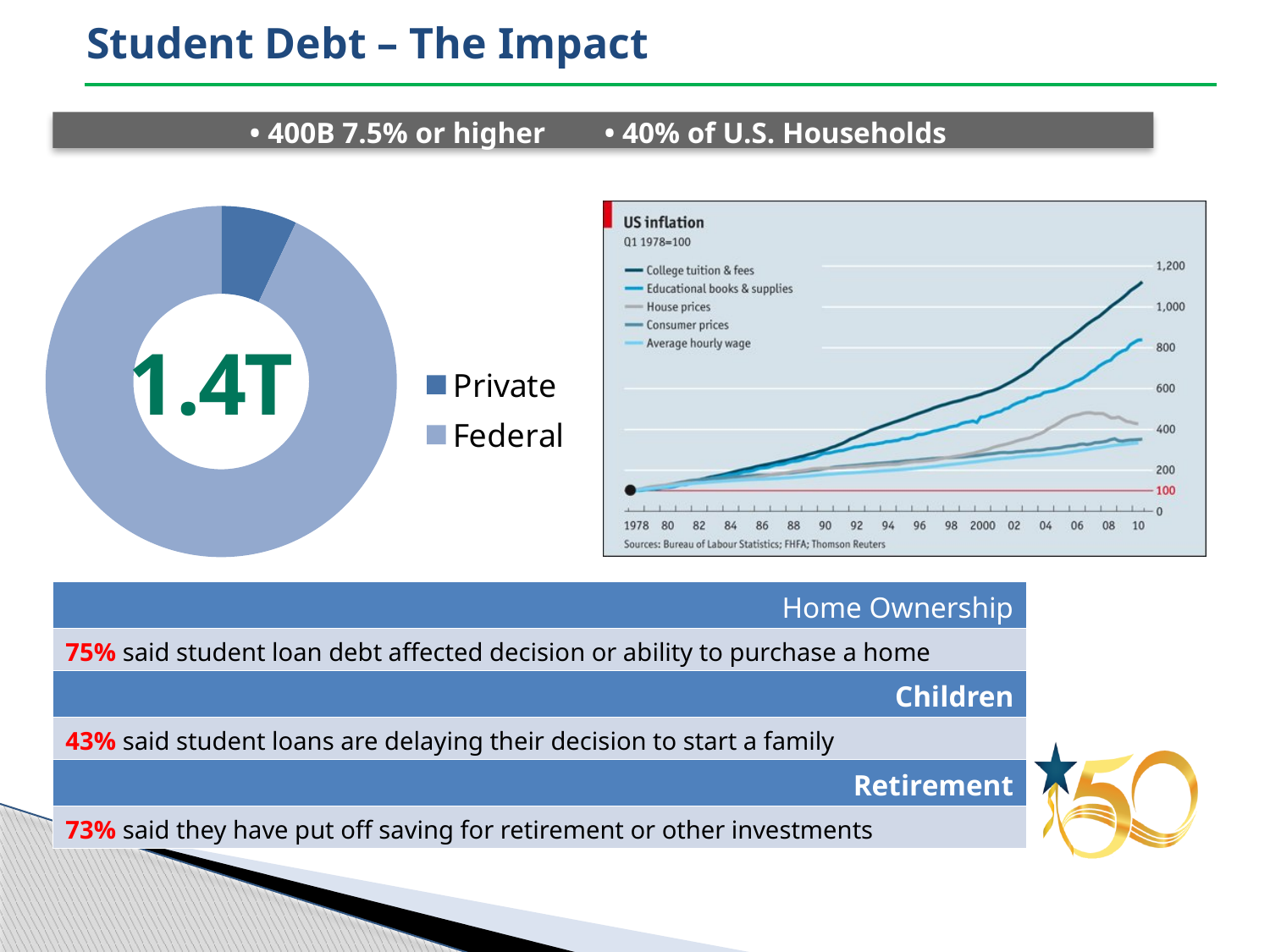
On the US inflation chart, is the value for Educational books & supplies in 2010 greater or less than 600? greater On the US inflation chart, is the value for Average hourly wage in 2010 greater or less than 400? less What is the title of the line chart on the right? US inflation What value is printed in the centre of the donut chart on the left? 1.4T What kind of chart is the chart on the left of the slide? Donut (pie) chart On the US inflation chart, is the value for College tuition & fees in 2010 greater or less than 1,000? greater On the donut chart on the left, which of the two segments, Private or Federal, is larger? Federal On the US inflation chart, what is the index value all series start at in Q1 1978? 100 On the US inflation chart, how many series does the legend list? 5 On the US inflation chart, which series is highest at the end of the period (2010)? College tuition & fees On the US inflation chart, does the College tuition & fees series rise or fall from 1978 to 2010? rise On the donut chart on the left, how many categories does the legend list? 2